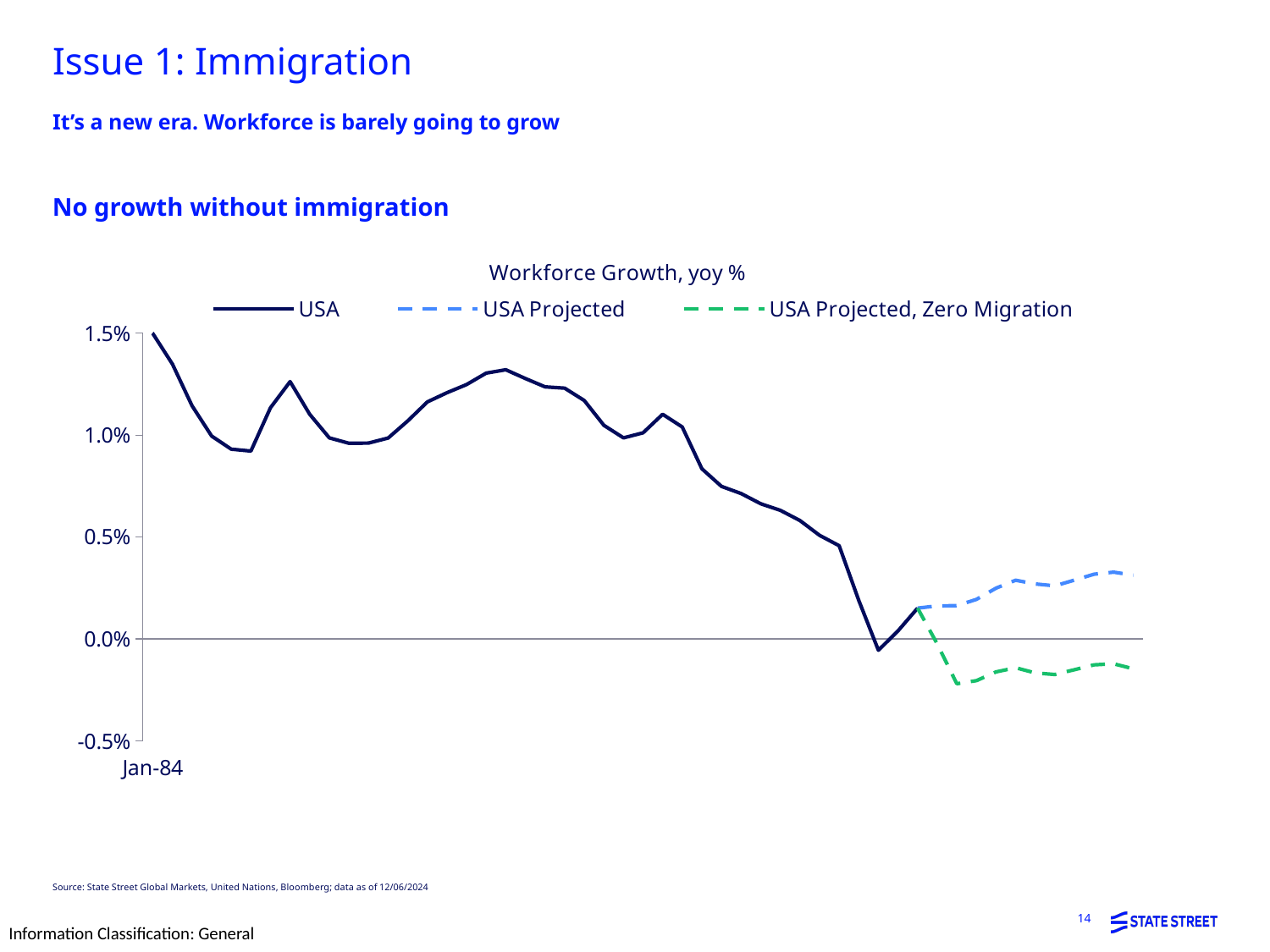
At the right-hand end of the chart, which is higher: USA Projected or USA Projected, Zero Migration? USA Projected Is the USA Projected series greater or less than 0.0% at its right-hand end? greater Is the USA Projected, Zero Migration series greater or less than 0.0% at its right-hand end? less Which series is lowest at the right-hand end of the chart? USA Projected, Zero Migration Is the USA series greater or less than 1.0% at Jan-84? greater What is the value of the USA series at Jan-84, the first point on the chart? 1.5% Which series are listed in the chart legend? USA, USA Projected, USA Projected, Zero Migration What is the title of the chart? Workforce Growth, yoy % How many series does the chart legend list? 3 What kind of chart is shown on the slide? line chart Does the USA series overall rise or fall from Jan-84 to the end of the solid line? fall